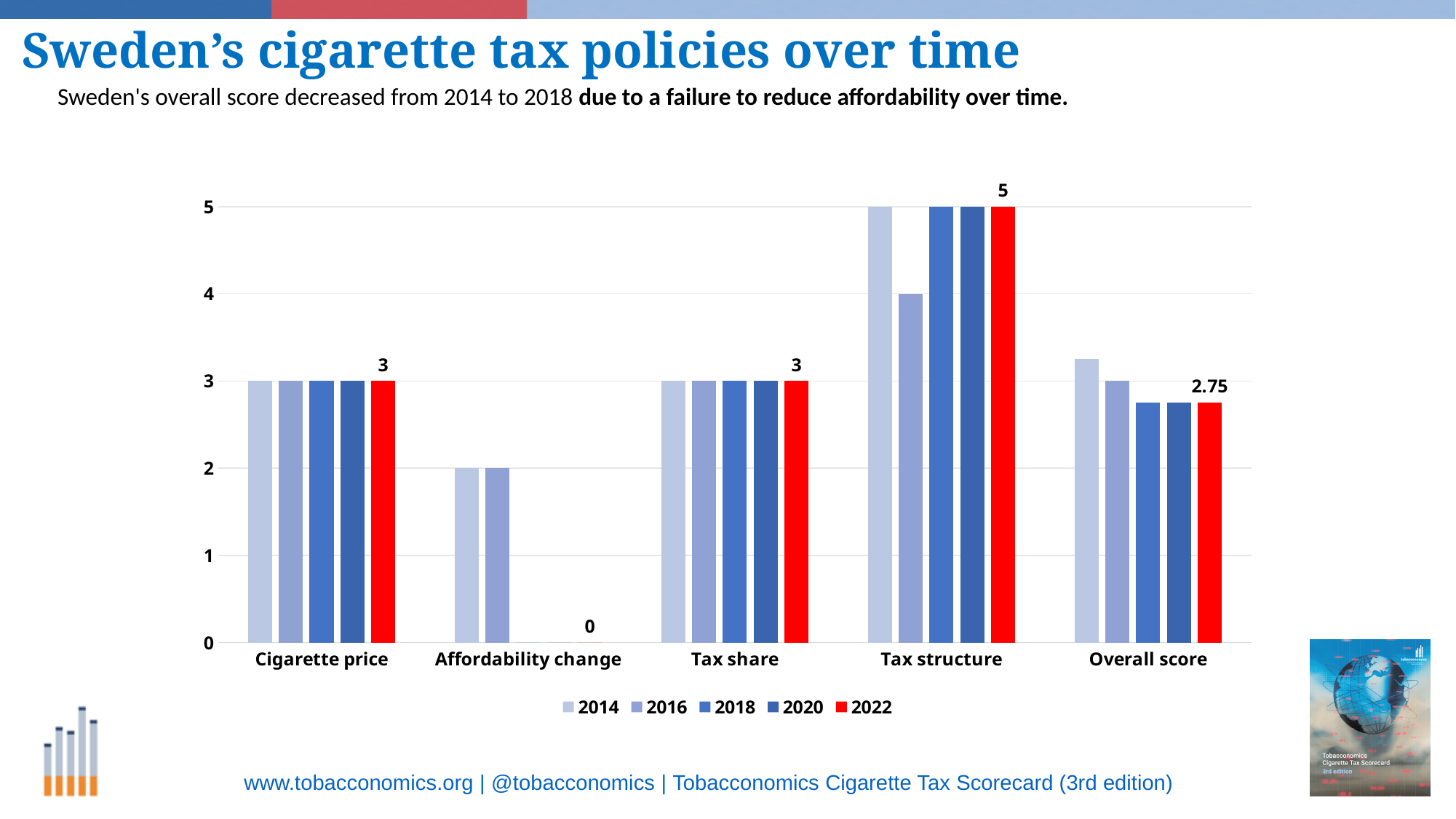
How many categories are shown on the x axis? 5 What is the value for Affordability change in 2022? 0 What kind of chart is shown on the slide? bar chart What is the value for Overall score in 2022? 2.75 What is the difference between the 2022 values for Tax structure and Overall score? 2.25 Which category has the lowest value in 2022? Affordability change What is the value for Tax structure in 2022? 5 Is the value for Overall score in 2014 greater or less than 3? greater What is the value for Tax structure in 2016? 4 How many series does the legend list? 5 Which is larger in 2022: Tax structure or Cigarette price? Tax structure Which category has the highest value in 2022? Tax structure